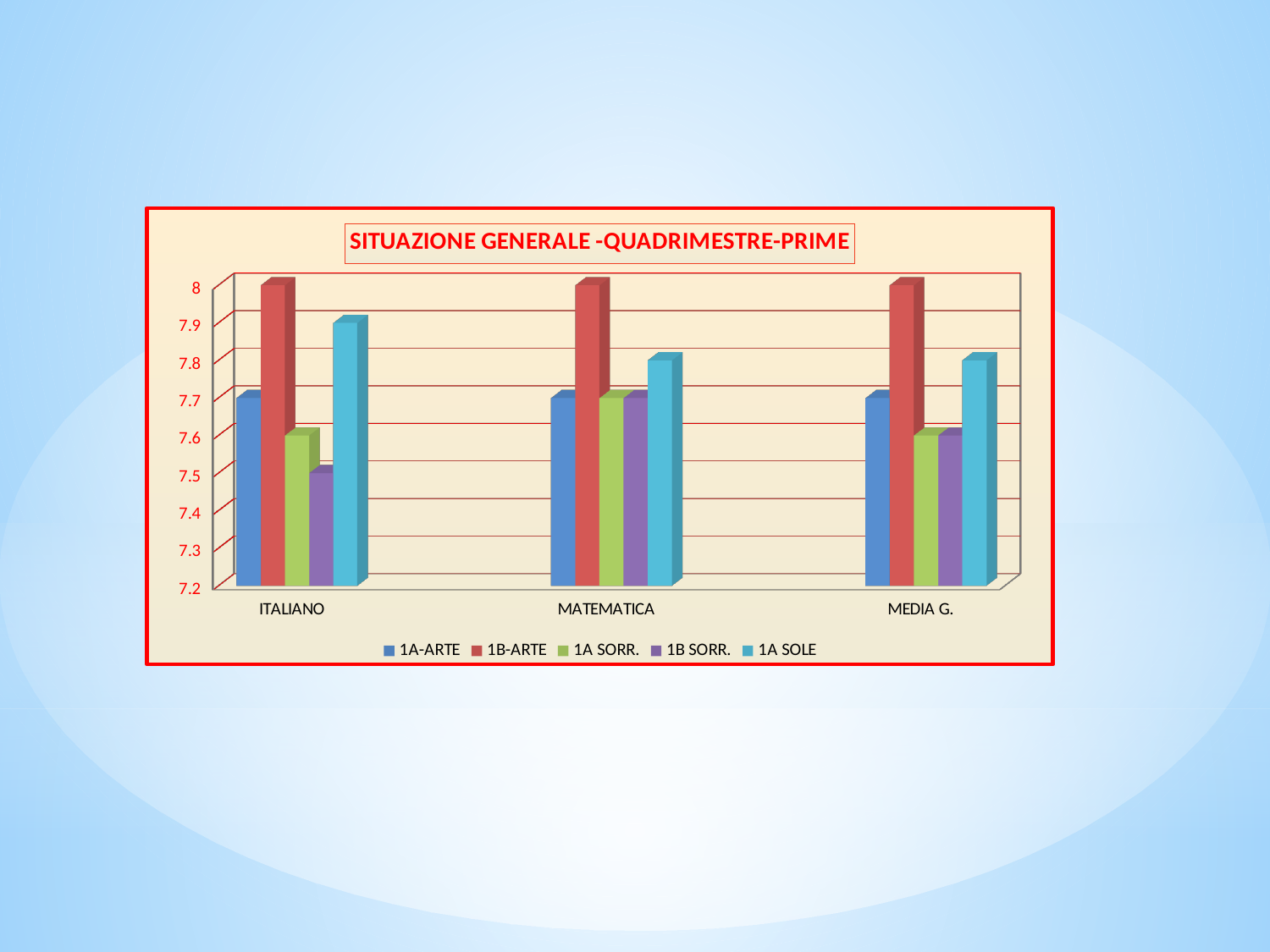
What kind of chart is shown on the slide? bar chart How many categories are shown on the x axis? 3 Which series has the highest value for ITALIANO? 1B-ARTE Is the value for 1B SORR. in ITALIANO greater or less than 7.6? less Which series has the lowest value for ITALIANO? 1B SORR. Which is larger for MEDIA G.: 1A-ARTE or 1A SORR.? 1A-ARTE Which series is shown in red in the legend? 1B-ARTE How many series does the legend list? 5 Which is larger for MATEMATICA: 1A SOLE or 1A SORR.? 1A SOLE What is the title of the chart? SITUAZIONE GENERALE -QUADRIMESTRE-PRIME Is the value for 1A SOLE in ITALIANO greater or less than 7.8? greater What value does the 1B-ARTE bar reach for MATEMATICA? 8